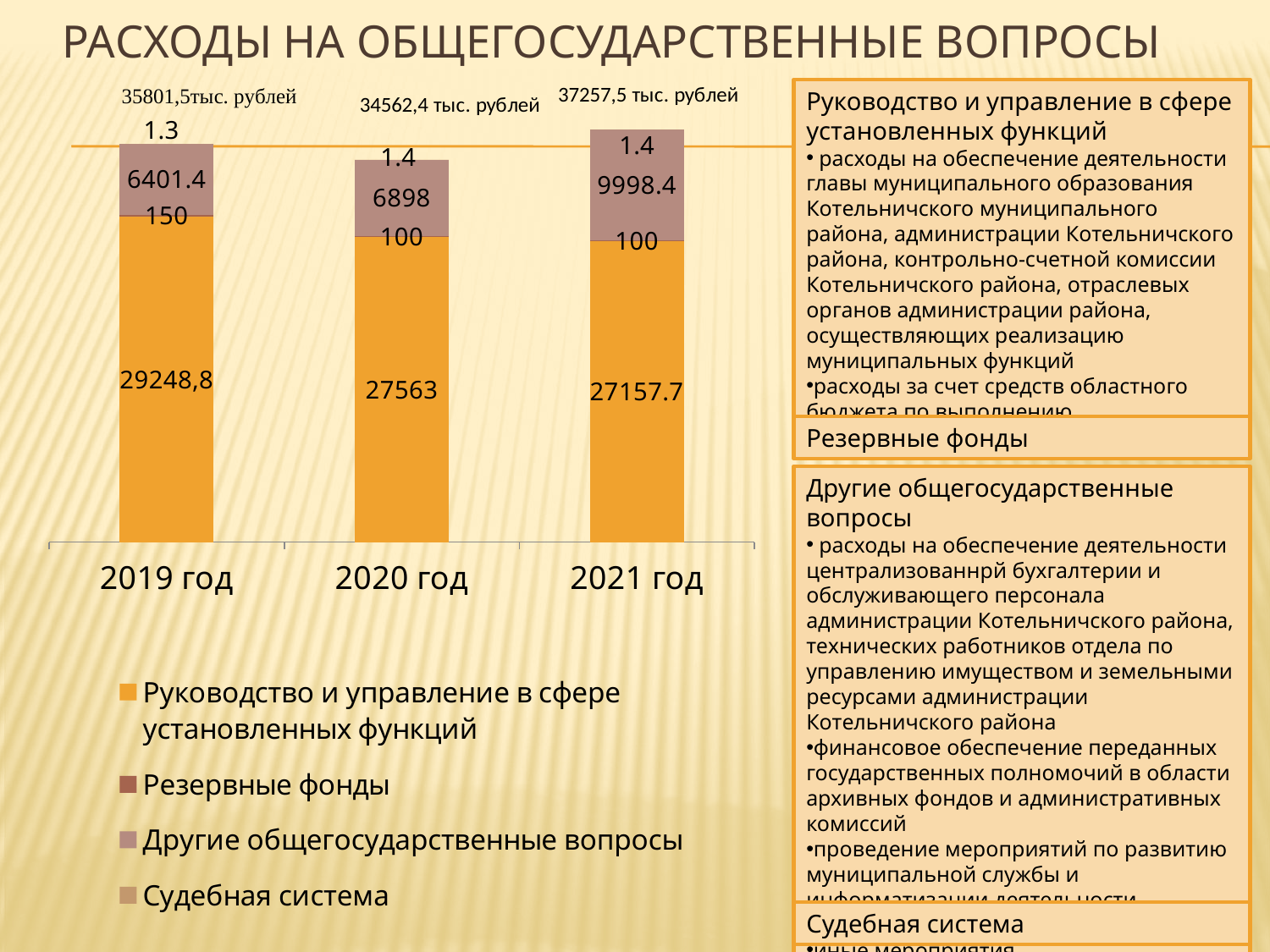
How many series does the chart legend list? 4 In which year is the value for Руководство и управление в сфере установленных функций the lowest? 2021 год Which is larger: the Руководство и управление в сфере установленных функций value for 2019 год or for 2020 год? 2019 год What is the value for Другие общегосударственные вопросы in 2021 год? 9998.4 How many years are shown on the x axis of the chart? 3 What kind of chart is shown on the slide? Stacked bar chart What is the difference between the Другие общегосударственные вопросы values for 2021 год and 2019 год? 3597 What is the total of the stacked bar for 2021 год, as printed above it? 37257,5 тыс. рублей What is the value for Руководство и управление в сфере установленных функций in 2019 год? 29248,8 What is the value for Судебная система in 2020 год? 1.4 In which year is the value for Другие общегосударственные вопросы the highest? 2021 год What is the value for Резервные фонды in 2019 год? 150